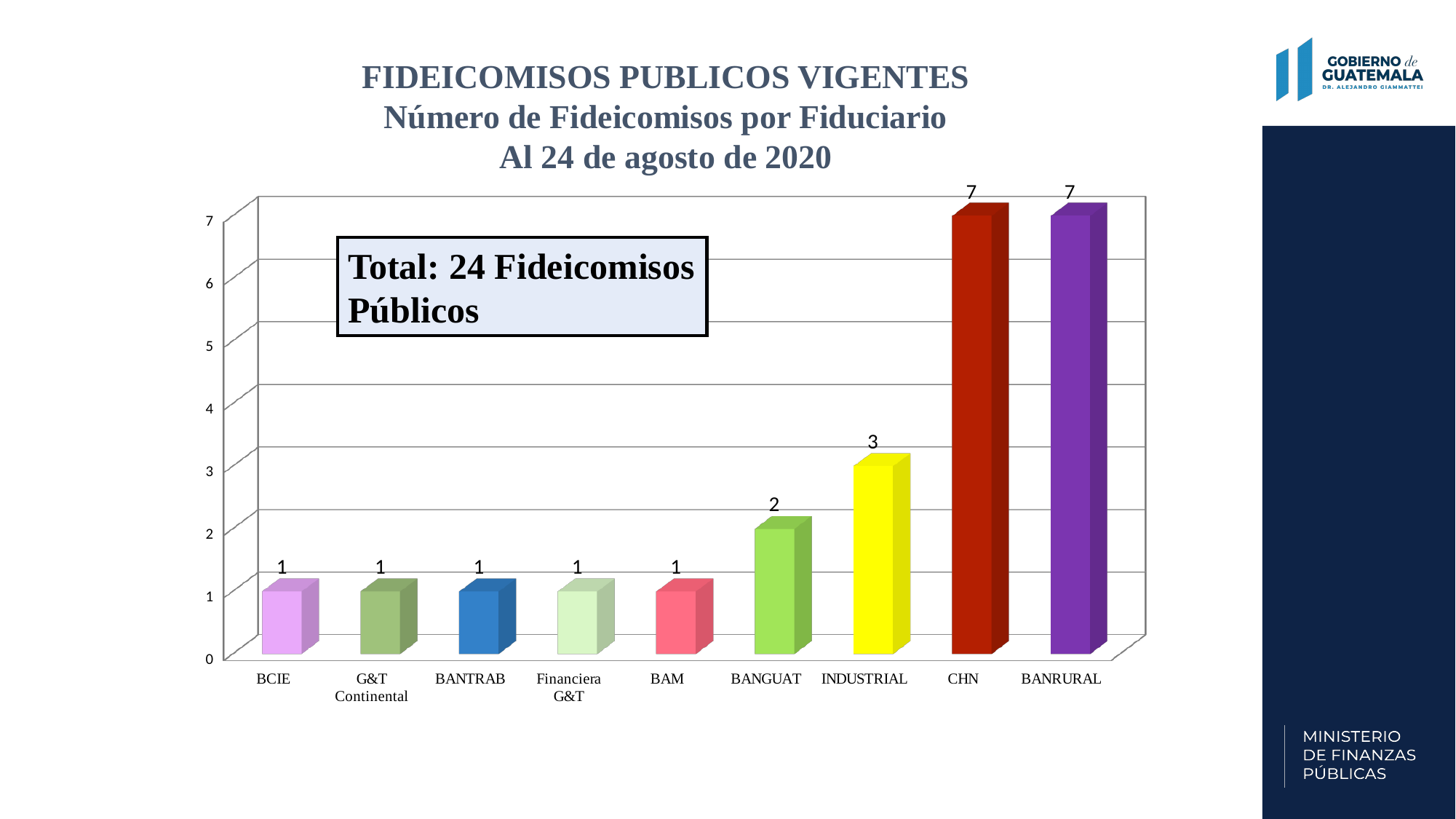
Do the values rise or fall from left to right along the x axis? rise Which category has the lowest value among BAM, BANGUAT and INDUSTRIAL? BAM What kind of chart is shown on the slide? bar chart What is the difference between the values for BANRURAL and INDUSTRIAL? 4 What is the value for INDUSTRIAL? 3 How many categories are shown on the x axis? 9 What is the value for CHN? 7 Which is larger, the value for BANGUAT or the value for Financiera G&T? BANGUAT What total number of fideicomisos públicos is stated in the box on the chart? 24 What date is given in the chart title? 24 de agosto de 2020 What is the value for BANGUAT? 2 What is the value for BANTRAB? 1